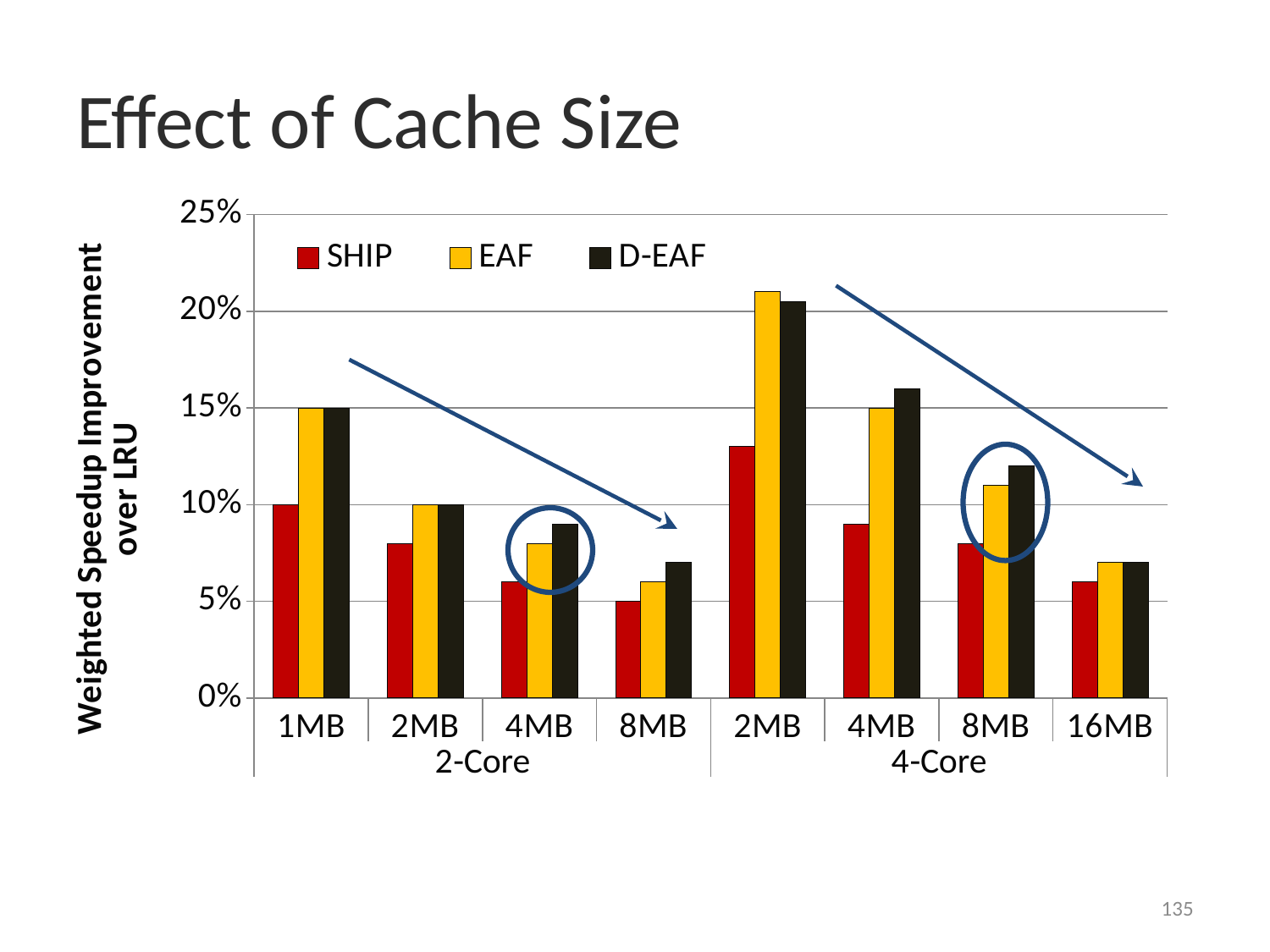
What is the SHIP value for 1MB in the 2-Core group? 10% What is the title of the slide's chart? Effect of Cache Size What is the SHIP value for 8MB in the 2-Core group? 5% Is the EAF value for 2MB in the 4-Core group greater or less than 20%? greater What type of chart is shown on the slide? bar chart What is the EAF value for 4MB in the 4-Core group? 15% What is the label of the vertical axis? Weighted Speedup Improvement over LRU Is the SHIP value for 4MB in the 2-Core group greater or less than 10%? less Within the 2-Core group, do the SHIP values rise or fall as cache size increases? fall What is the EAF value for 1MB in the 2-Core group? 15% How many series does the legend list? 3 Which cache size has the highest EAF value in the 4-Core group? 2MB